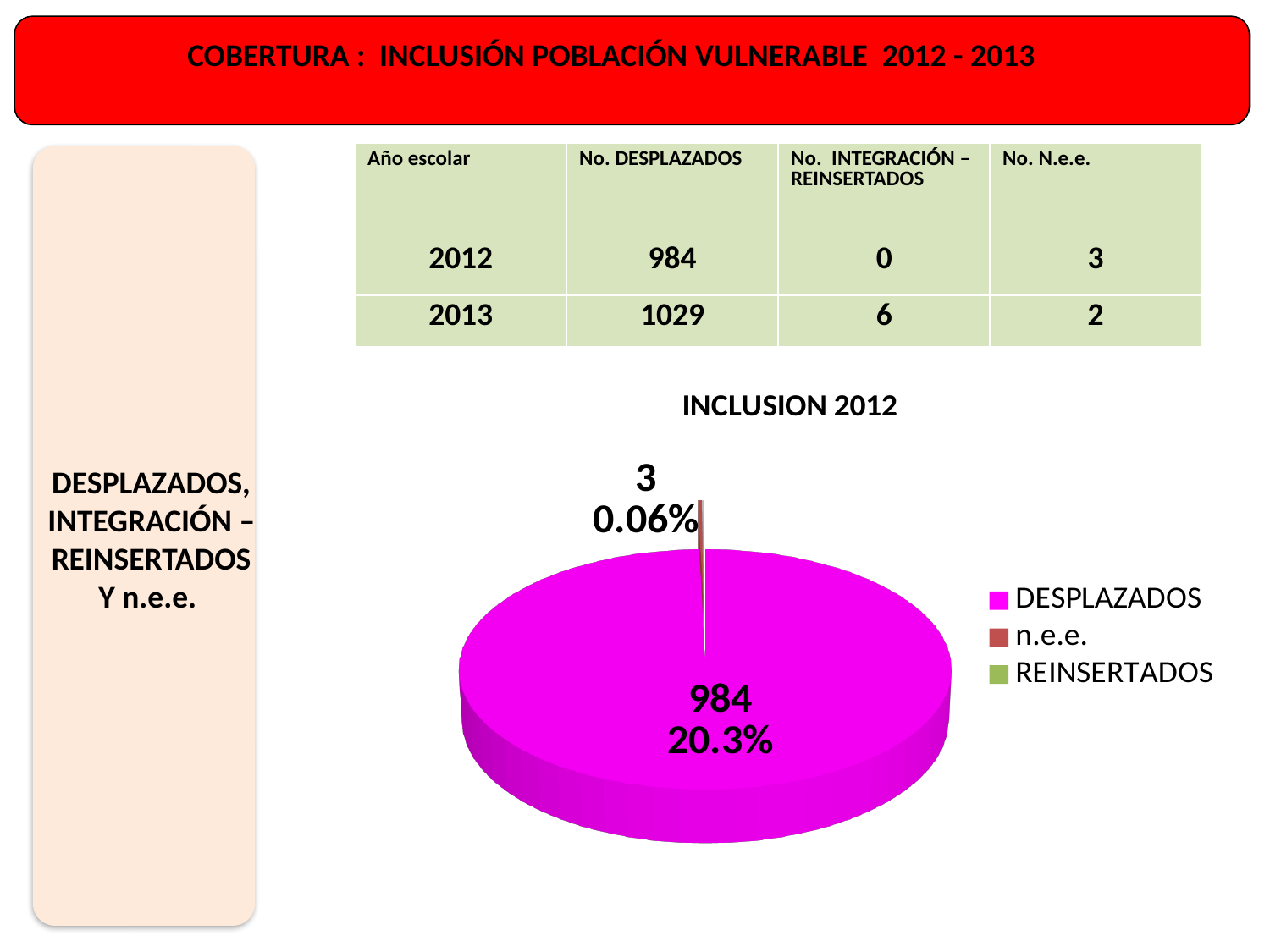
Which category has the largest slice in the pie chart? DESPLAZADOS What percentage is printed on the DESPLAZADOS slice? 20.3% What colour is the DESPLAZADOS slice in the pie chart? magenta What kind of chart is shown on the slide? pie chart What value is labelled on the n.e.e. slice of the pie chart? 3 What is the title of the chart? INCLUSION 2012 What percentage is printed on the n.e.e. slice? 0.06% What value is labelled on the DESPLAZADOS slice of the pie chart? 984 What is the difference between the labelled values for DESPLAZADOS and n.e.e.? 981 How many entries does the chart's legend list? 3 Which is larger in the pie chart, DESPLAZADOS or n.e.e.? DESPLAZADOS